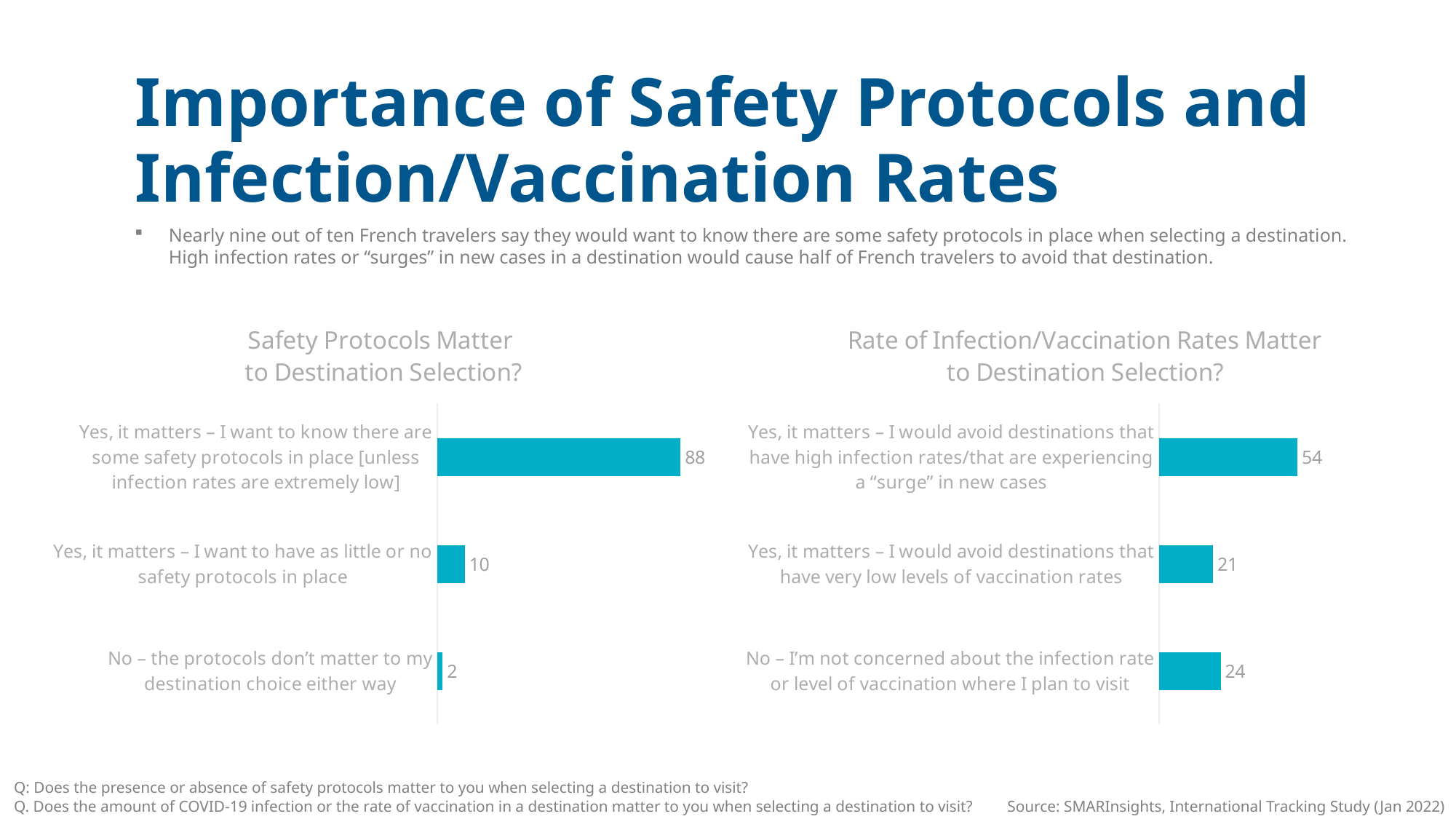
In the 'Rate of Infection/Vaccination Rates Matter to Destination Selection?' chart, what is the value for 'No – I'm not concerned about the infection rate or level of vaccination where I plan to visit'? 24 In the 'Safety Protocols Matter to Destination Selection?' chart, what is the difference between the value for wanting some safety protocols in place (88) and wanting as little or no safety protocols (10)? 78 In the 'Safety Protocols Matter to Destination Selection?' chart, what is the value for 'Yes, it matters – I want to know there are some safety protocols in place [unless infection rates are extremely low]'? 88 In the 'Rate of Infection/Vaccination Rates Matter to Destination Selection?' chart, which is larger: the value for avoiding destinations with very low vaccination rates or the value for not being concerned about infection rate? Not concerned about the infection rate (24) In the 'Rate of Infection/Vaccination Rates Matter to Destination Selection?' chart, what is the value for 'Yes, it matters – I would avoid destinations that have very low levels of vaccination rates'? 21 In the 'Rate of Infection/Vaccination Rates Matter to Destination Selection?' chart, what is the difference between the value for avoiding high infection rate destinations (54) and the value for not being concerned (24)? 30 How many categories are shown in the 'Safety Protocols Matter to Destination Selection?' chart? 3 In the 'Safety Protocols Matter to Destination Selection?' chart, which category has the lowest value? No – the protocols don't matter to my destination choice either way What type of chart is the 'Rate of Infection/Vaccination Rates Matter to Destination Selection?' chart? Bar chart In the 'Rate of Infection/Vaccination Rates Matter to Destination Selection?' chart, which category has the highest value? Yes, it matters – I would avoid destinations that have high infection rates/that are experiencing a "surge" in new cases What is the title of the chart on the left side of the slide? Safety Protocols Matter to Destination Selection? In the 'Safety Protocols Matter to Destination Selection?' chart, what is the value for 'No – the protocols don't matter to my destination choice either way'? 2